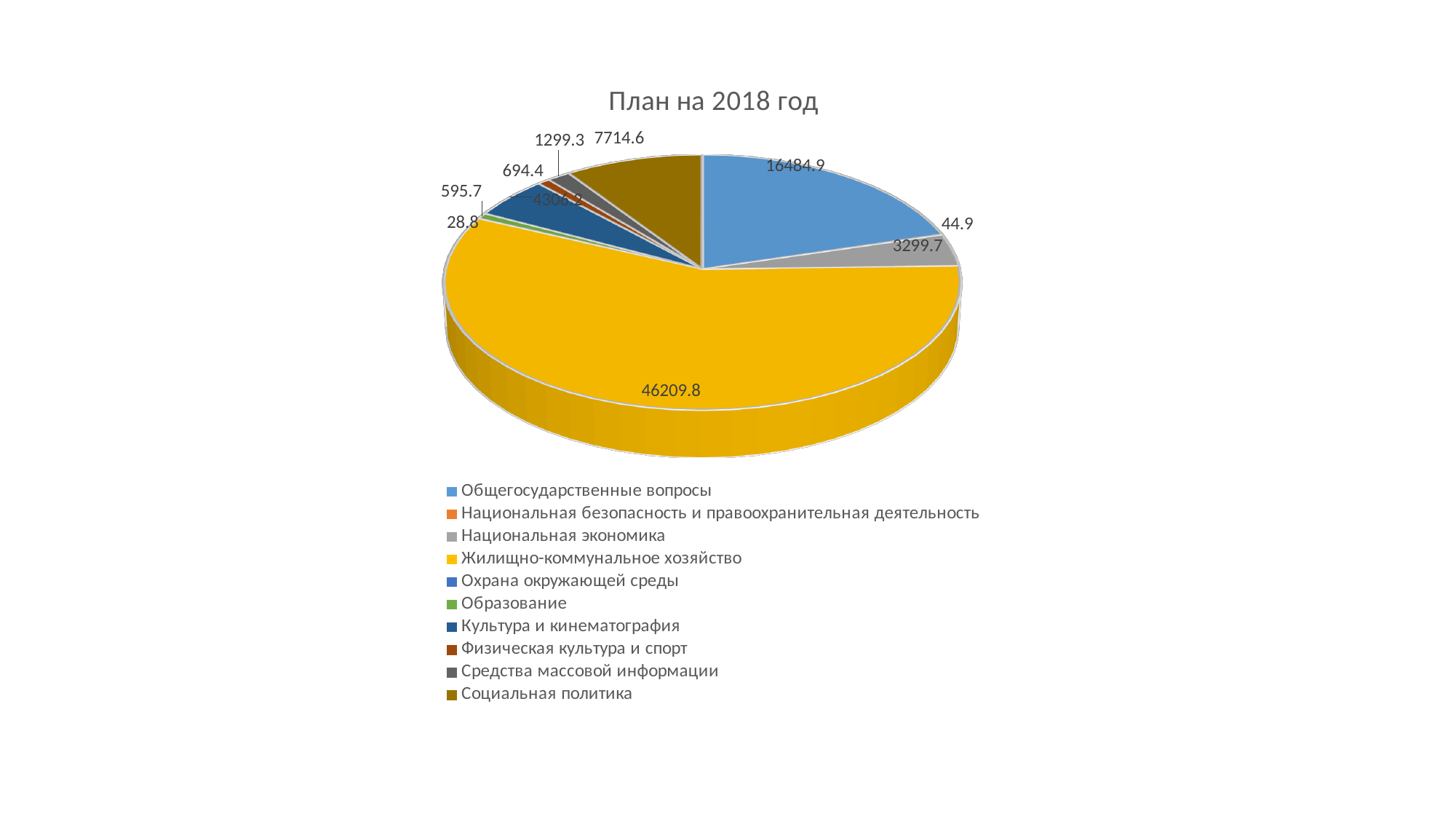
Which category has the largest slice of the pie? Жилищно-коммунальное хозяйство What is the value for Национальная экономика? 3299.7 Which category has the smallest value? Охрана окружающей среды What is the value for Средства массовой информации? 1299.3 What is the value for Социальная политика? 7714.6 What is the difference between the values for Общегосударственные вопросы and Социальная политика? 8770.3 What is the value for Общегосударственные вопросы? 16484.9 What is the value for Жилищно-коммунальное хозяйство? 46209.8 Which is larger, Общегосударственные вопросы or Социальная политика? Общегосударственные вопросы How many categories does the legend list? 10 What is the title of the chart? План на 2018 год What kind of chart is shown on the slide? pie chart